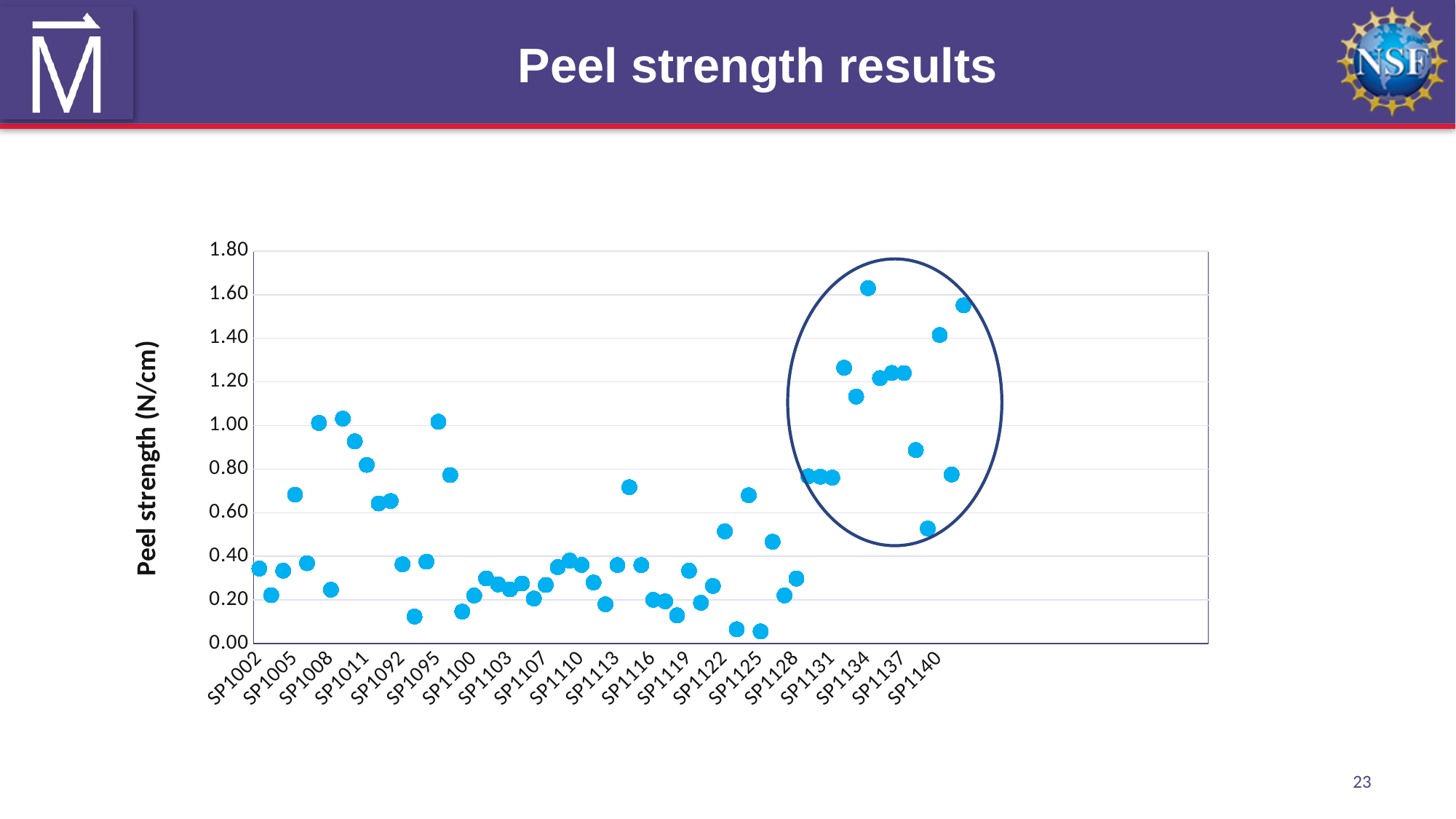
Is any plotted value greater than 1.80? no Is the highest plotted peel strength value greater or less than 1.40? greater Are the points inside the circled region generally higher or lower than the points outside it? higher What is the title of the chart? Peel strength results Is the value plotted for SP1002 greater or less than 0.20? greater What kind of chart is shown on the slide? scatter chart What is the highest tick value shown on the y axis? 1.80 How many sample labels are shown along the x axis? 20 What is the label on the y axis of the chart? Peel strength (N/cm)